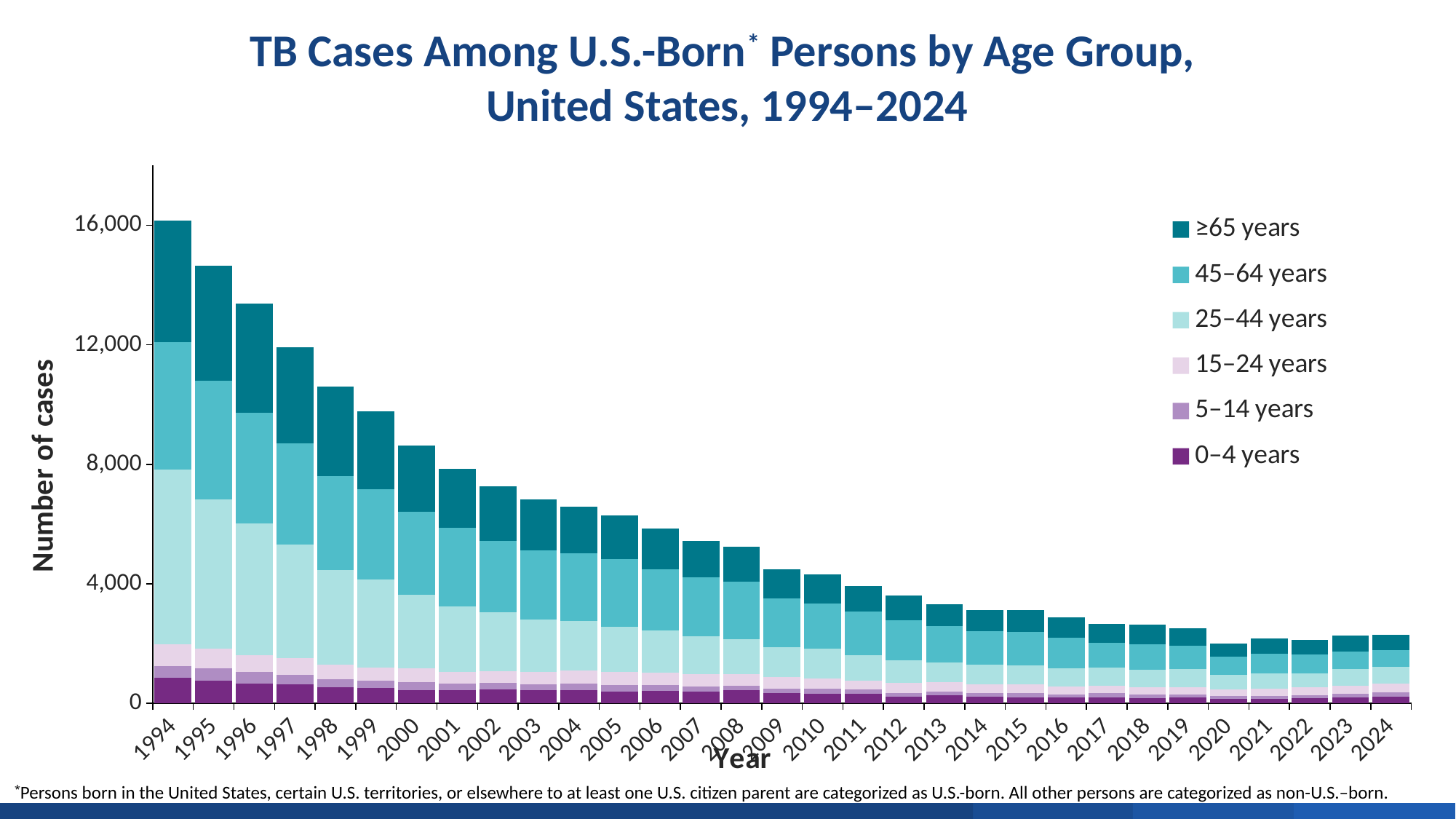
Is the total number of cases in 2000 greater or less than 8,000? greater Which year has the highest total number of TB cases among U.S.-born persons? 1994 Do the total TB cases among U.S.-born persons generally rise or fall from 1994 to 2024? Fall Is the total number of cases in 2024 greater or less than 4,000? less What is the label of the y axis? Number of cases Which year has a larger total number of cases, 1995 or 2005? 1995 How many years are plotted along the x axis? 31 Which age group is listed first (at the top) in the legend? ≥65 years Which year has the lowest total number of TB cases among U.S.-born persons? 2020 Is the total number of cases in 1994 greater or less than 12,000? greater How many age-group series does the legend list? 6 What kind of chart is shown on the slide? Stacked bar chart